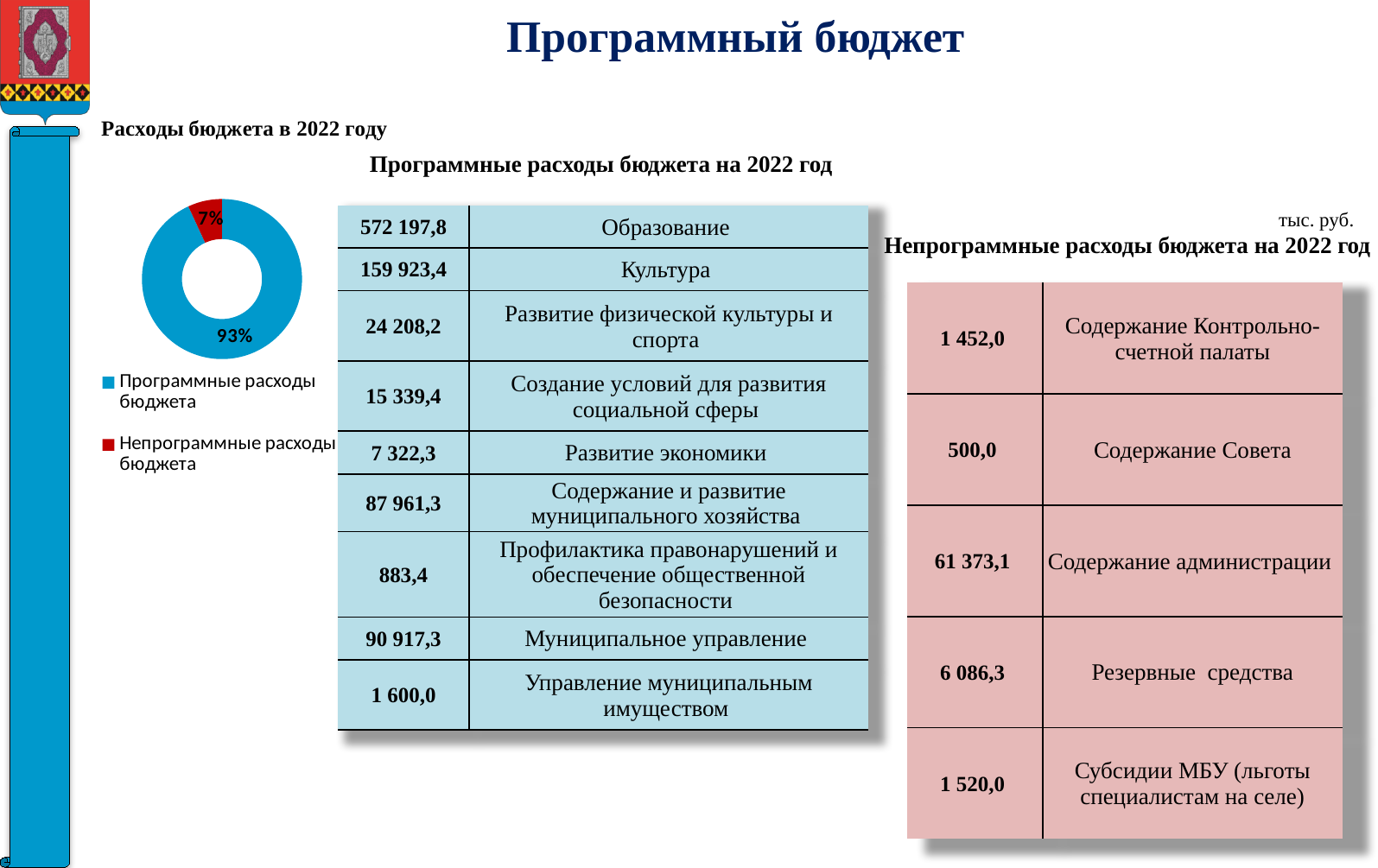
By how many percentage points does the "Программные расходы бюджета" slice exceed the "Непрограммные расходы бюджета" slice? 86 percentage points What is the title shown above the pie chart? Расходы бюджета в 2022 году How many slices does the pie chart have? 2 Which category has the smallest slice in the pie chart? Непрограммные расходы бюджета What kind of chart is shown on the slide? Doughnut chart Which category has the largest slice in the pie chart? Программные расходы бюджета What share of the pie chart is labelled "Программные расходы бюджета"? 93% How many entries does the pie chart's legend list? 2 What share of the pie chart is labelled "Непрограммные расходы бюджета"? 7% What colour is the "Непрограммные расходы бюджета" slice in the pie chart? Red Which is larger in the pie chart: "Программные расходы бюджета" or "Непрограммные расходы бюджета"? Программные расходы бюджета